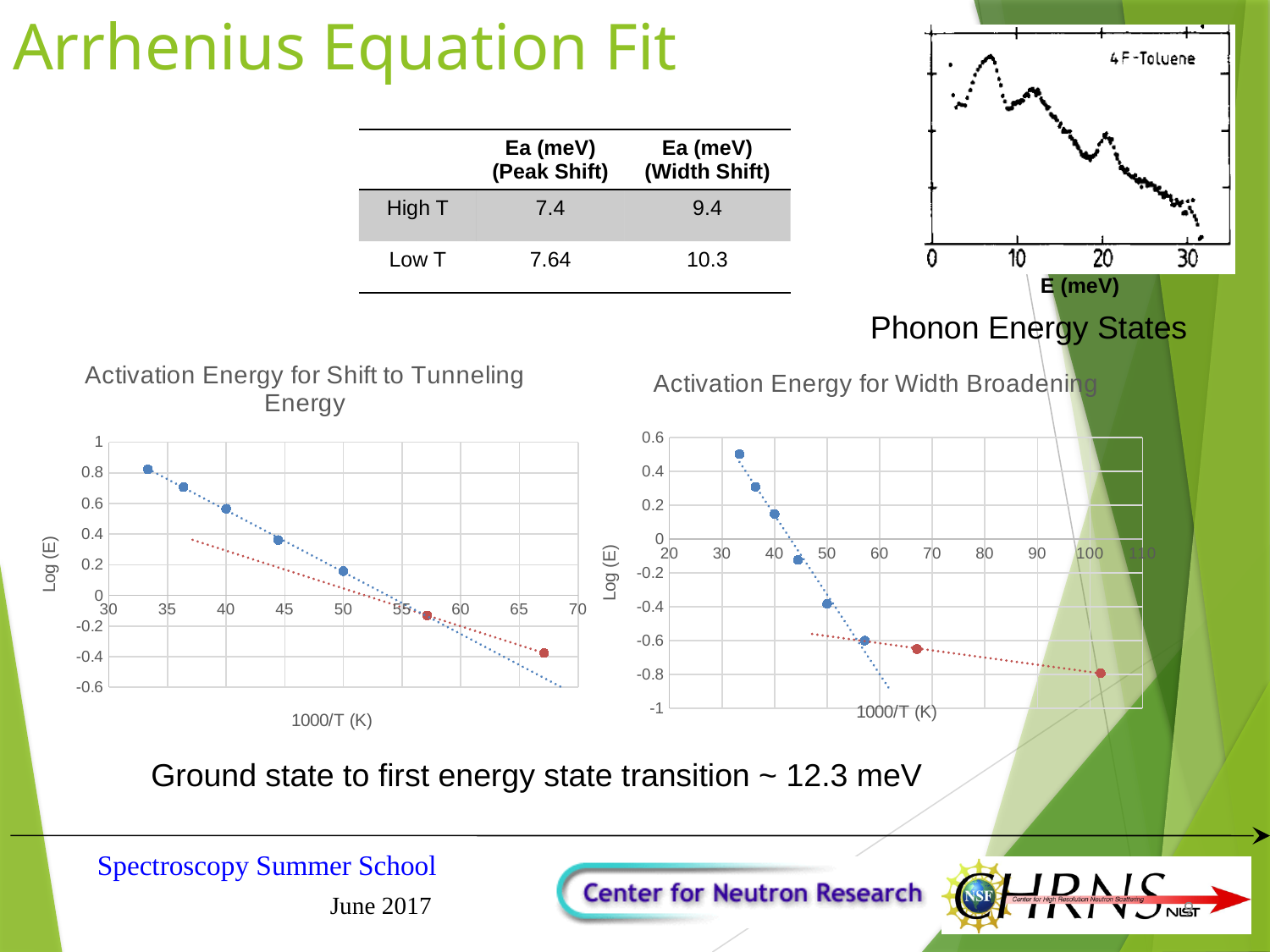
What is the y-axis label of the 'Activation Energy for Shift to Tunneling Energy' chart? Log (E) In the 'Activation Energy for Shift to Tunneling Energy' chart, do the Log(E) values rise or fall as 1000/T increases? fall In the 'Activation Energy for Width Broadening' chart, is the Log(E) value of the rightmost point greater or less than -0.6? less In the 'Activation Energy for Width Broadening' chart, do the Log(E) values rise or fall as 1000/T increases? fall What kind of chart is 'Activation Energy for Width Broadening'? scatter chart How many data points are plotted in the 'Activation Energy for Shift to Tunneling Energy' chart? 7 What kind of chart is 'Activation Energy for Shift to Tunneling Energy'? scatter chart In the 'Activation Energy for Width Broadening' chart, is the Log(E) value of the leftmost point greater or less than 0.4? greater In the 'Activation Energy for Shift to Tunneling Energy' chart, is the Log(E) value of the leftmost point greater or less than 0.6? greater What is the x-axis label of the 'Activation Energy for Width Broadening' chart? 1000/T (K)